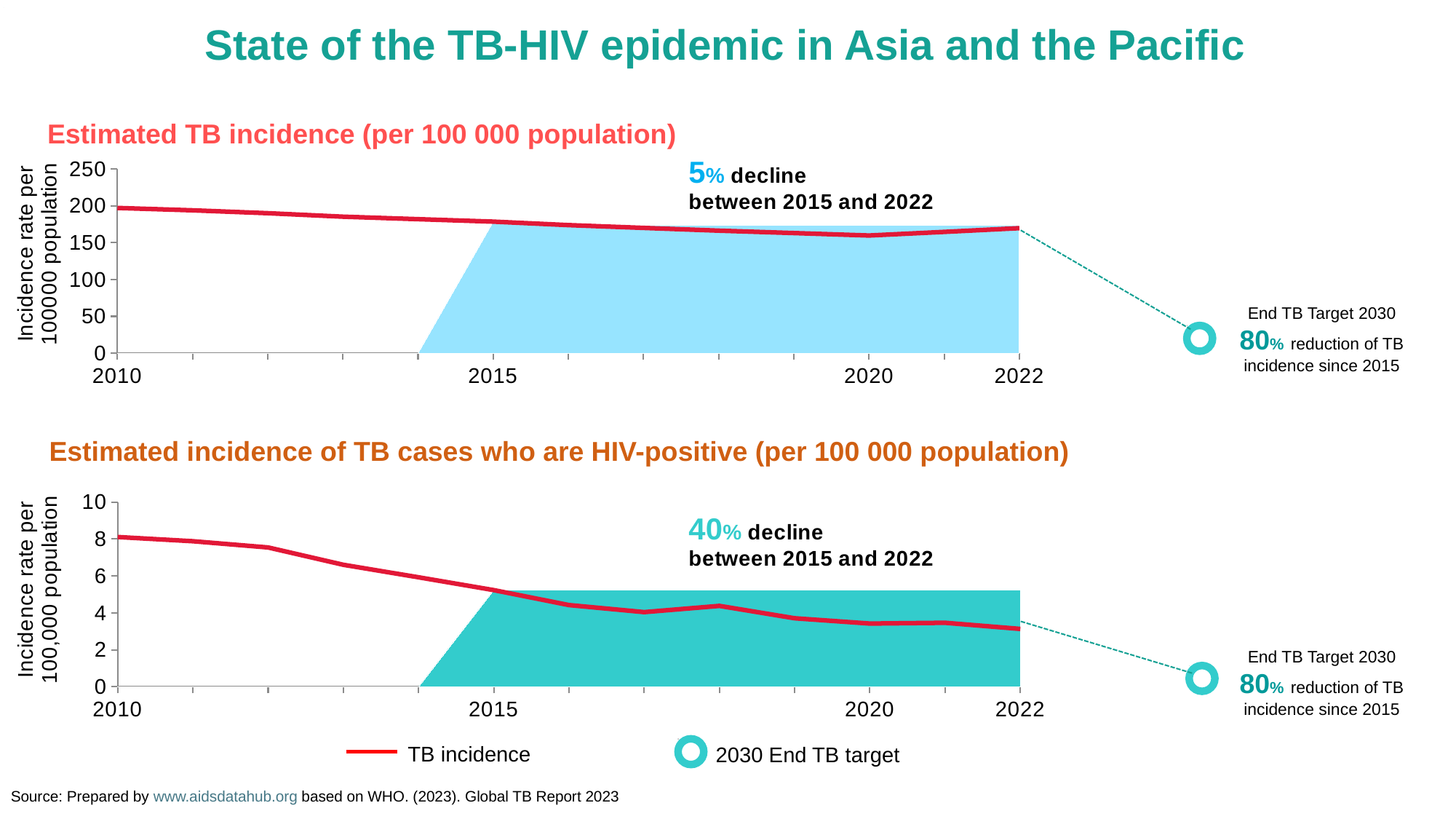
In the 'Estimated TB incidence (per 100 000 population)' chart, is the value for 2022 greater or less than 200? less In the 'Estimated incidence of TB cases who are HIV-positive (per 100 000 population)' chart, what percentage decline between 2015 and 2022 is stated? 40% What kind of chart is the 'Estimated TB incidence (per 100 000 population)' chart? combination area and line chart In the 'Estimated TB incidence (per 100 000 population)' chart, is the value for 2010 greater or less than 150? greater How many entries does the legend at the bottom of the slide list? 2 In the 'Estimated TB incidence (per 100 000 population)' chart, does TB incidence rise or fall overall from 2010 to 2022? fall In the 'Estimated TB incidence (per 100 000 population)' chart, which is larger, the value for 2010 or the value for 2022? 2010 In the 'Estimated TB incidence (per 100 000 population)' chart, what percentage decline between 2015 and 2022 is stated? 5% In the 'Estimated incidence of TB cases who are HIV-positive (per 100 000 population)' chart, which year has the highest value? 2010 In the 'Estimated incidence of TB cases who are HIV-positive (per 100 000 population)' chart, is the value for 2022 greater or less than 4? less In the 'Estimated incidence of TB cases who are HIV-positive (per 100 000 population)' chart, what reduction of TB incidence since 2015 is the End TB Target 2030? 80%